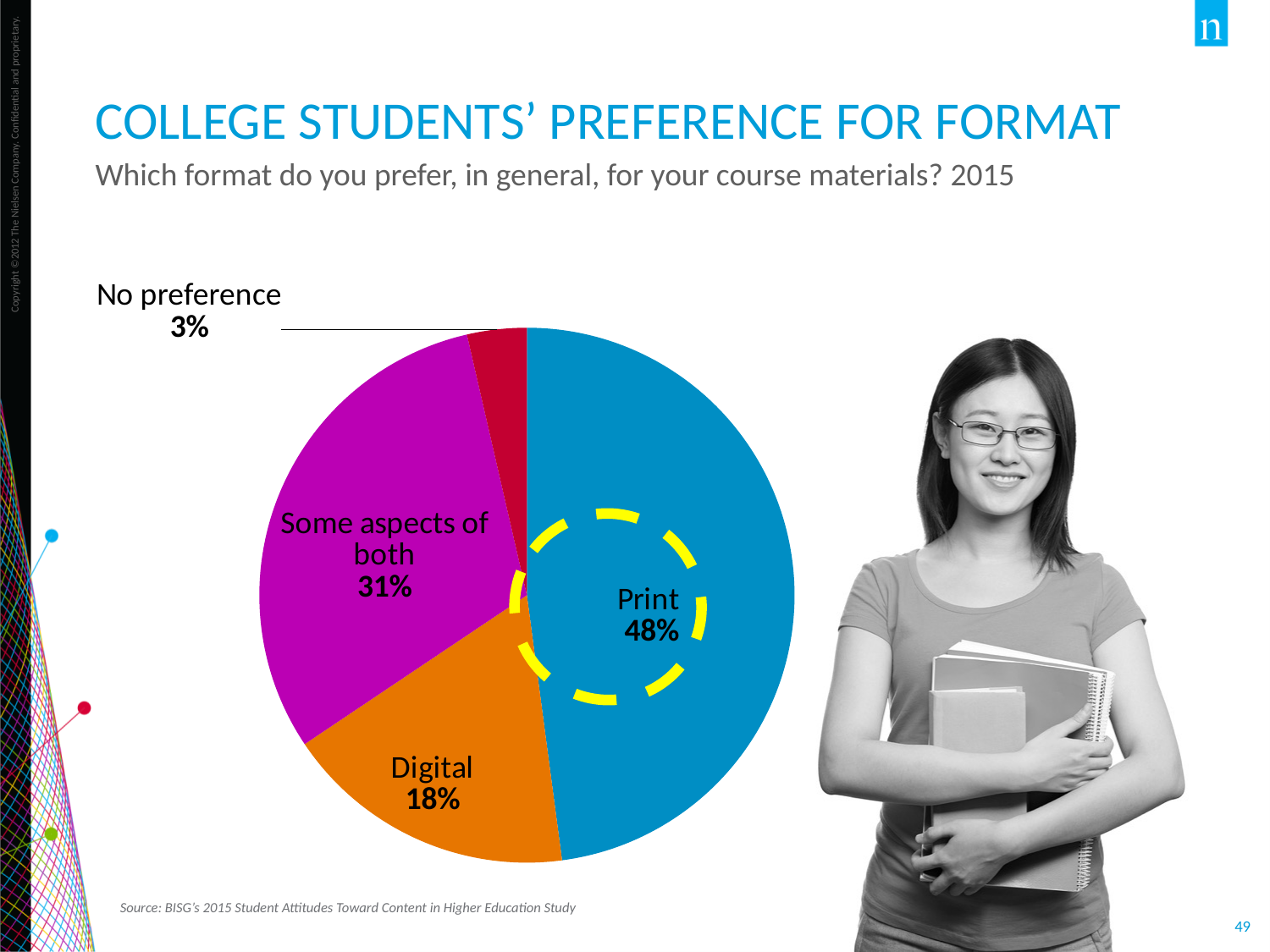
What is the difference in percentage points between Some aspects of both and No preference? 28 What percentage of students have no preference? 3% What percentage of students prefer Digital? 18% What colour is the Print slice of the pie? Blue What share of college students prefer Print for their course materials? 48% Which is larger, the share for Some aspects of both or the share for Digital? Some aspects of both Which format has the largest share of the pie? Print What is the difference in percentage points between Print and Digital? 30 What kind of chart is shown on the slide? Pie chart Which category has the smallest share of the pie? No preference How many categories are shown in the pie chart? 4 What percentage of students prefer some aspects of both? 31%